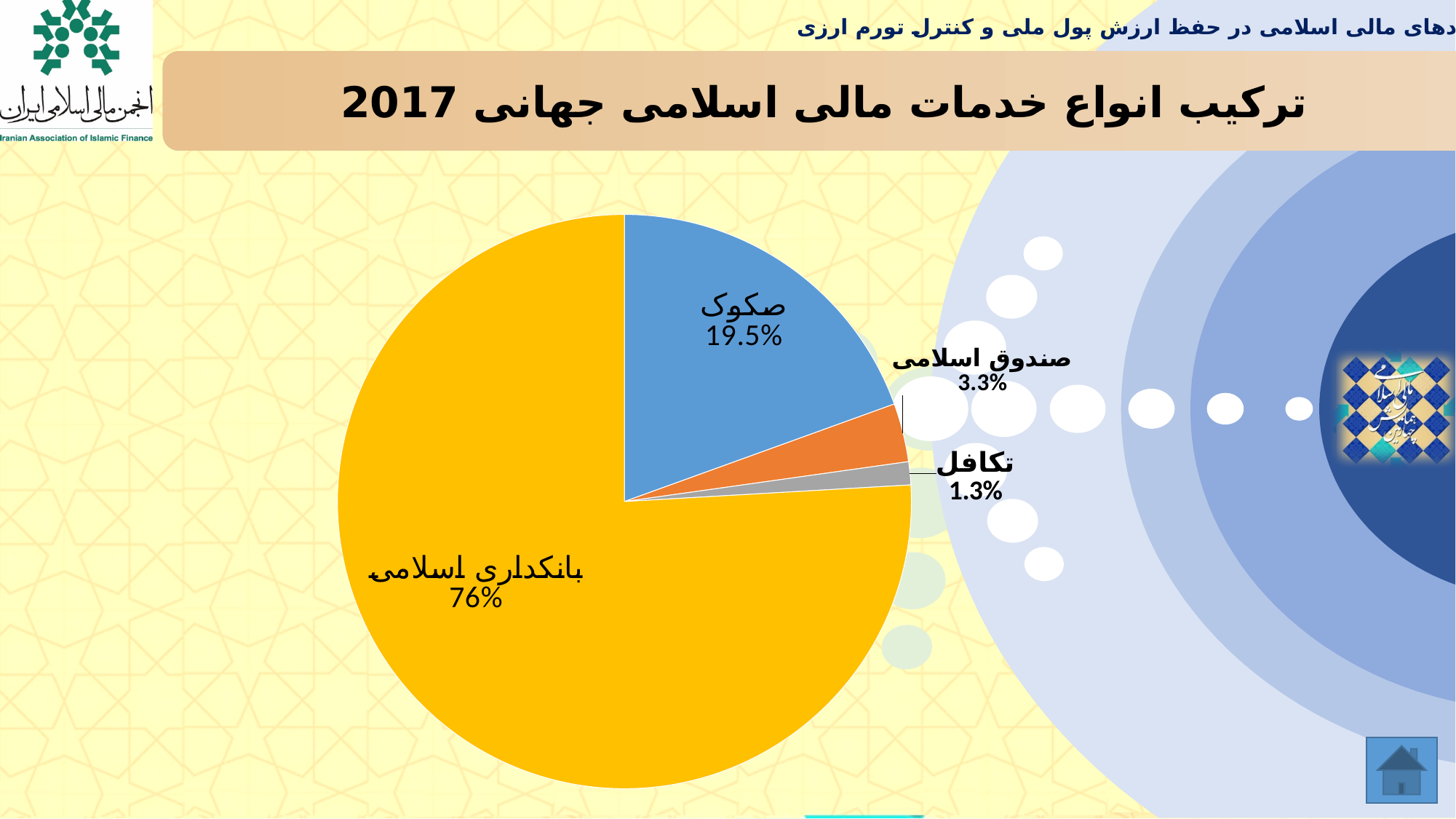
What is the difference between the shares of صکوک and صندوق اسلامی? 16.2% What year is given in the chart title? 2017 What is the value shown for صکوک (Sukuk)? 19.5% What is the value shown for صندوق اسلامی (Islamic funds)? 3.3% Which is larger, the share of صندوق اسلامی or the share of تکافل? صندوق اسلامی Which category has the smallest slice of the pie? تکافل What is the difference between the shares of بانکداری اسلامی and صکوک? 56.5% What share of the pie does بانکداری اسلامی (Islamic banking) hold? 76% How many slices does the pie chart have? 4 What kind of chart is shown on the slide? Pie chart What is the value shown for تکافل (Takaful)? 1.3% Which category has the largest slice of the pie? بانکداری اسلامی